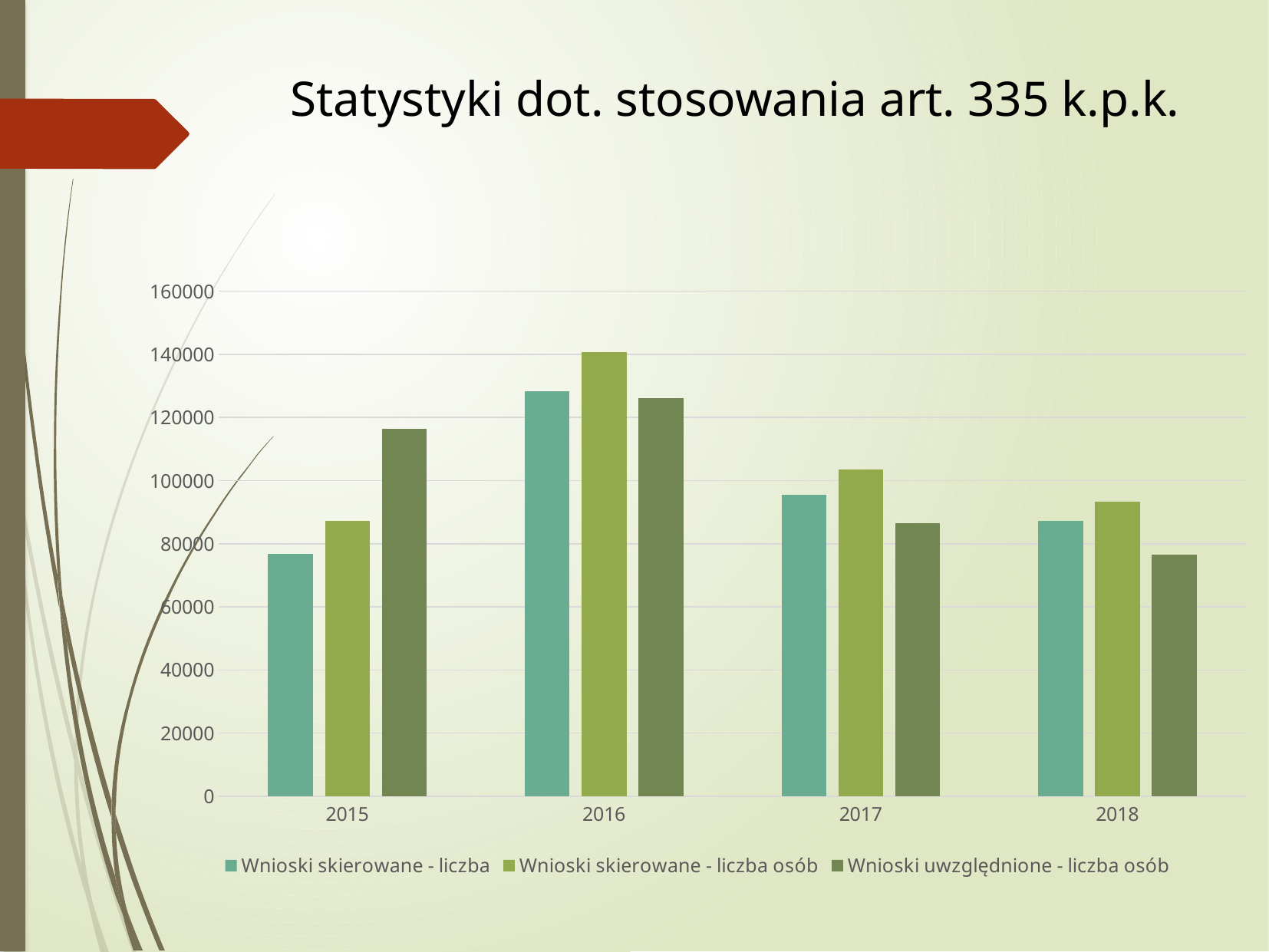
Is the value for 'Wnioski skierowane - liczba osób' in 2016 greater or less than 120000? greater How many years are shown on the x axis of the chart? 4 Do the values for 'Wnioski skierowane - liczba' rise or fall from 2016 to 2018? fall What is the first entry in the chart's legend? Wnioski skierowane - liczba In which year is the value for 'Wnioski skierowane - liczba osób' the highest? 2016 In 2015, which is larger: 'Wnioski uwzględnione - liczba osób' or 'Wnioski skierowane - liczba'? Wnioski uwzględnione - liczba osób What kind of chart is shown on the slide? bar chart Is the value for 'Wnioski skierowane - liczba' in 2015 greater or less than 100000? less How many series does the chart's legend list? 3 In which year is the value for 'Wnioski uwzględnione - liczba osób' the lowest? 2018 What is the title of the slide? Statystyki dot. stosowania art. 335 k.p.k. Is the value for 'Wnioski uwzględnione - liczba osób' in 2017 greater or less than 100000? less